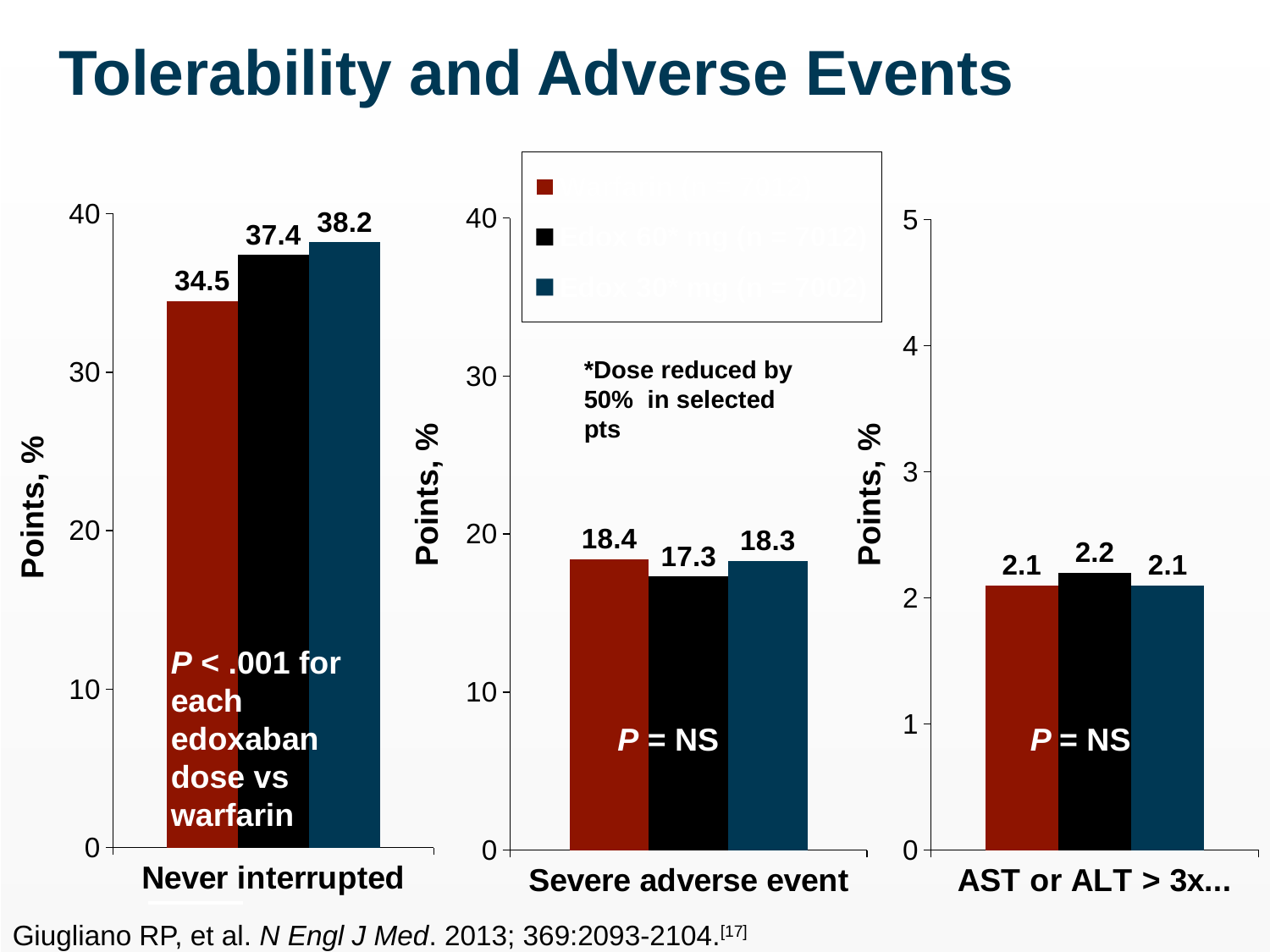
How many bars are shown in the 'Severe adverse event' chart? 3 In the 'Never interrupted' chart, which is larger, the red bar or the black bar? The black bar (37.4) In the 'Never interrupted' chart, what is the difference between the blue bar (38.2) and the red bar (34.5)? 3.7 In the 'AST or ALT > 3x...' chart, what is the value of the black (middle) bar? 2.2 In the 'Never interrupted' chart, is the value of the red bar greater or less than 30? greater What type of chart is used for 'AST or ALT > 3x...'? Bar chart In the 'Never interrupted' chart, what is the value of the red (left) bar? 34.5 In the 'Severe adverse event' chart, what is the value of the black (middle) bar? 17.3 In the 'Severe adverse event' chart, how much larger is the red bar than the black bar? 1.1 What is the y-axis label on the 'Never interrupted' chart? Points, % In the 'Severe adverse event' chart, which bar has the lowest value? The black (middle) bar, 17.3 In the 'Never interrupted' chart, which bar has the highest value? The blue (right) bar, 38.2